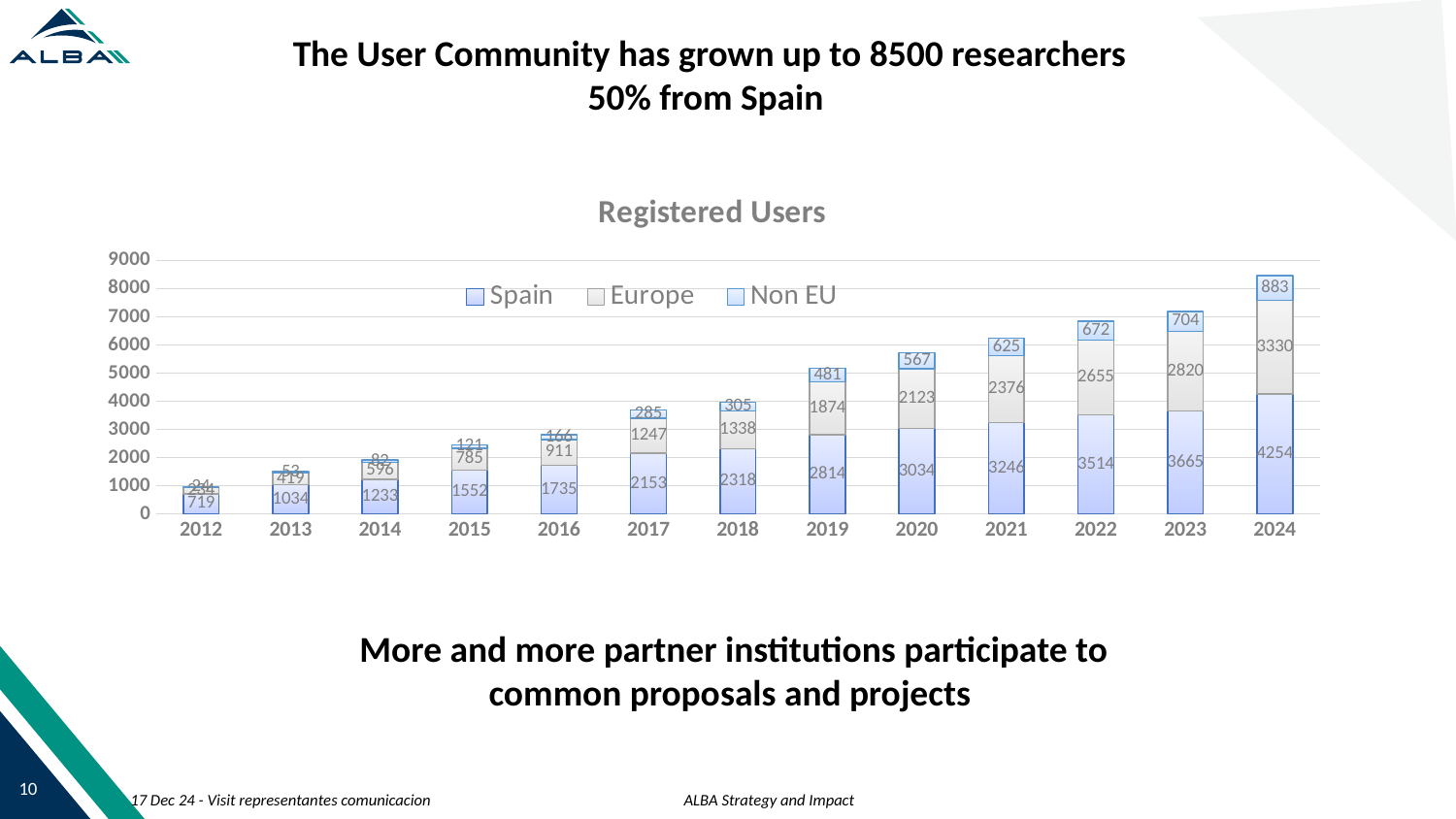
What is the value for Spain in 2024? 4254 In which year is the Spain value lowest? 2012 How many years are shown on the x axis of the chart? 13 In which year is the Spain value highest? 2024 Is the total of the stacked bar for 2024 greater or less than 8000? greater What is the total of the stacked bar for 2020? 5724 What kind of chart is shown on the slide? Stacked bar chart What is the title of the chart? Registered Users What is the value for Europe in 2019? 1874 What is the value for Non EU in 2022? 672 What is the difference between the Spain values for 2024 and 2023? 589 How many series does the chart legend list? 3